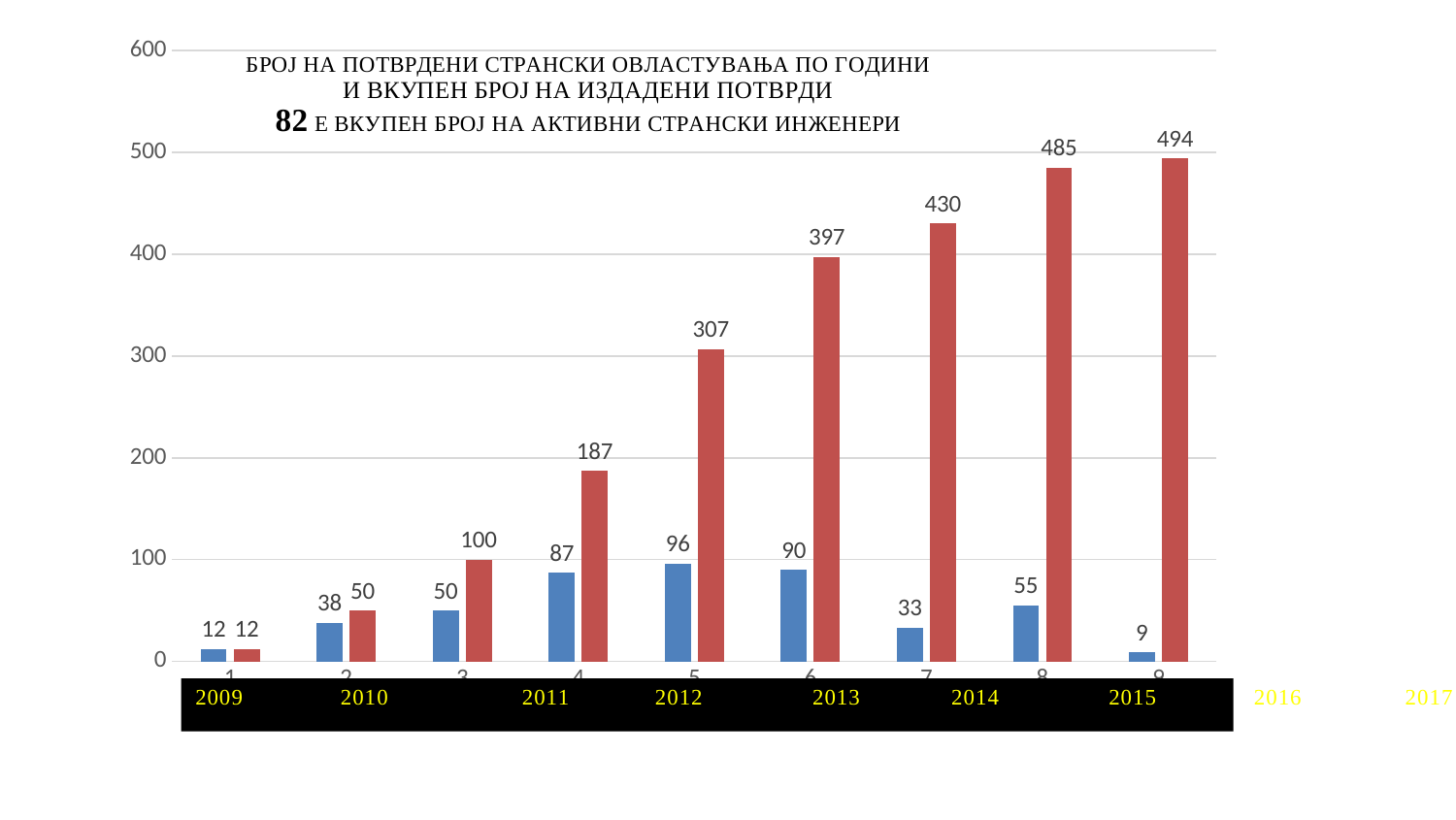
How many groups of bars are plotted in the chart? 9 Which group has the lowest blue bar? the ninth group (9) What is the difference between the blue bar values of the fourth and third groups? 37 What is the difference between the red bar values of the ninth and eighth groups? 9 What is the value of the red bar in the fourth group? 187 What is the value of the red bar in the last (ninth) group? 494 Which group has the highest blue bar? the fifth group (96) What number is shown in bold in the chart title text? 82 What is the value of the blue bar in the fifth group? 96 What type of chart is shown on the slide? bar chart Do the red bars rise or fall from left to right across the groups? rise In the seventh group, which bar is larger, the blue one or the red one? the red one (430)